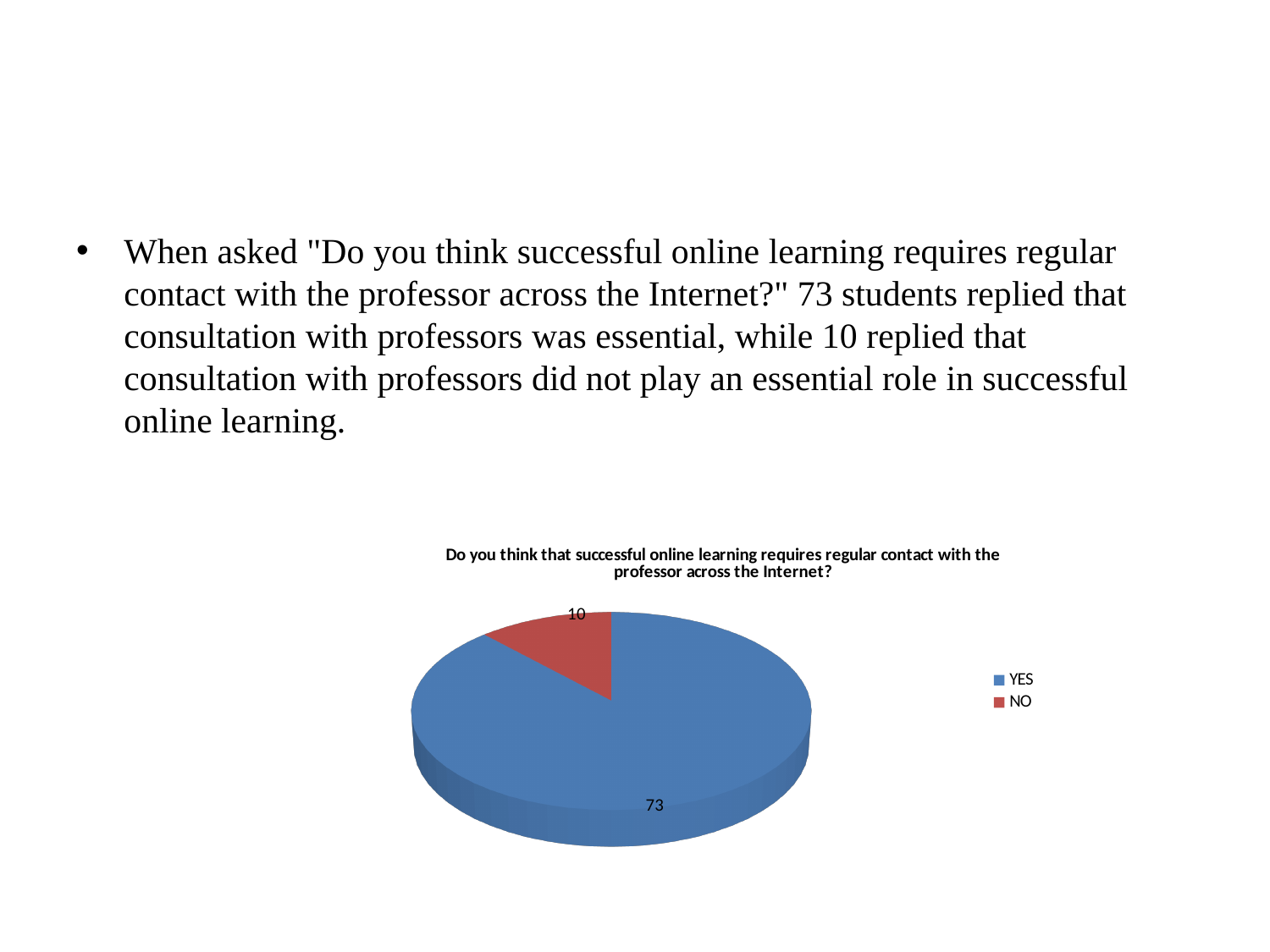
Which category has the smallest slice? NO What is the total of all slices in the pie chart? 83 What is the difference between the YES and NO values? 63 Which is larger, YES or NO? YES How many entries does the legend list? 2 What is the title of the chart? Do you think that successful online learning requires regular contact with the professor across the Internet? How many slices does the pie chart have? 2 What colour is the YES slice? blue What kind of chart is shown on the slide? pie chart Which category has the largest slice? YES What is the value for YES? 73 What is the value for NO? 10